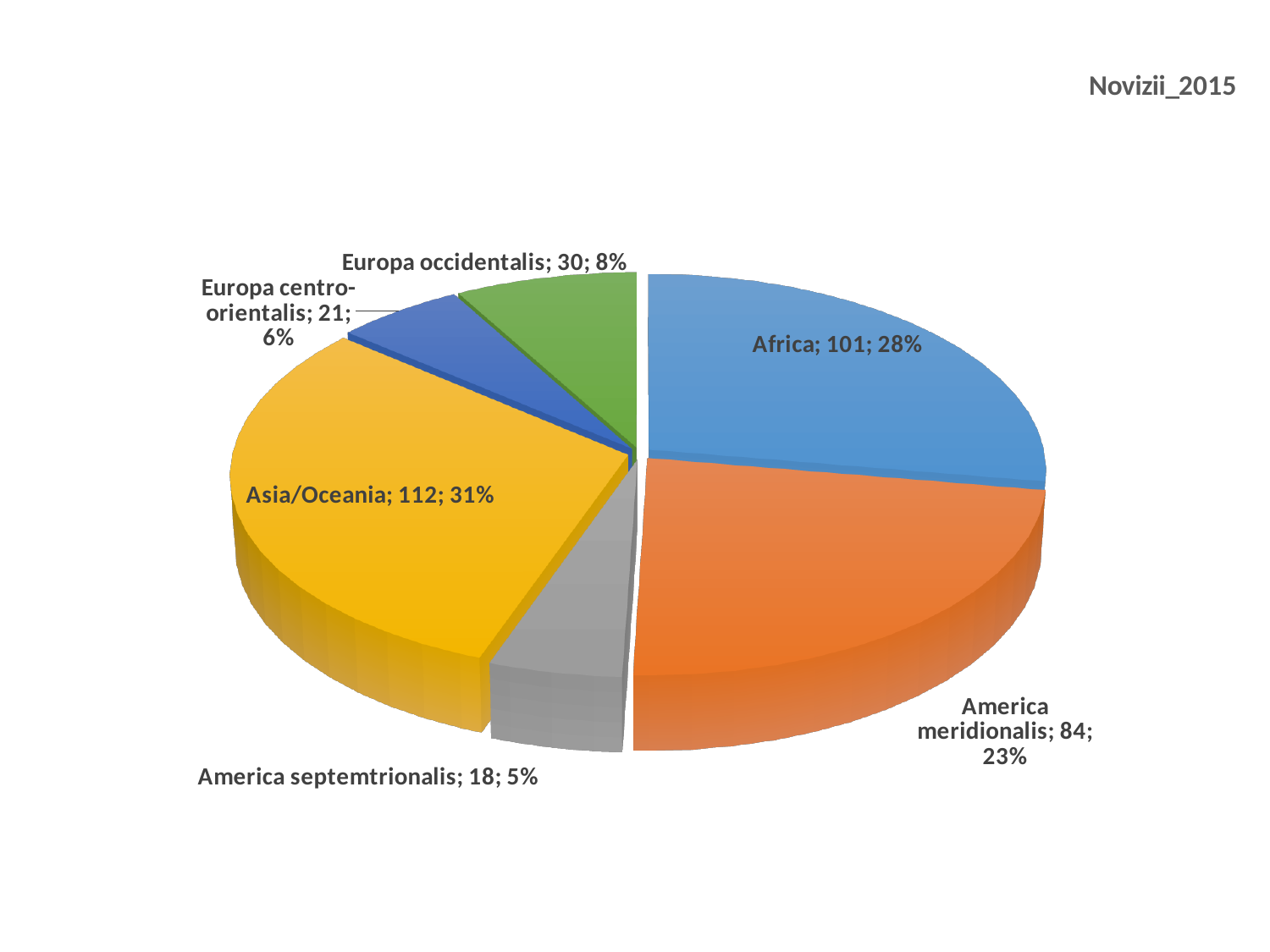
What percentage share does Europa occidentalis have? 8% What is the value for Africa? 101 What percentage share does Asia/Oceania have? 31% What is the difference between the values for Asia/Oceania and Africa? 11 What is the difference between the values for America meridionalis and America septemtrionalis? 66 What is the title shown on the slide? Novizii_2015 Which region has the largest slice? Asia/Oceania What is the value for America meridionalis? 84 What kind of chart is shown on the slide? pie chart Which region has the smallest slice? America septemtrionalis Which is larger, the value for Europa occidentalis or Europa centro-orientalis? Europa occidentalis How many slices does the pie chart have? 6